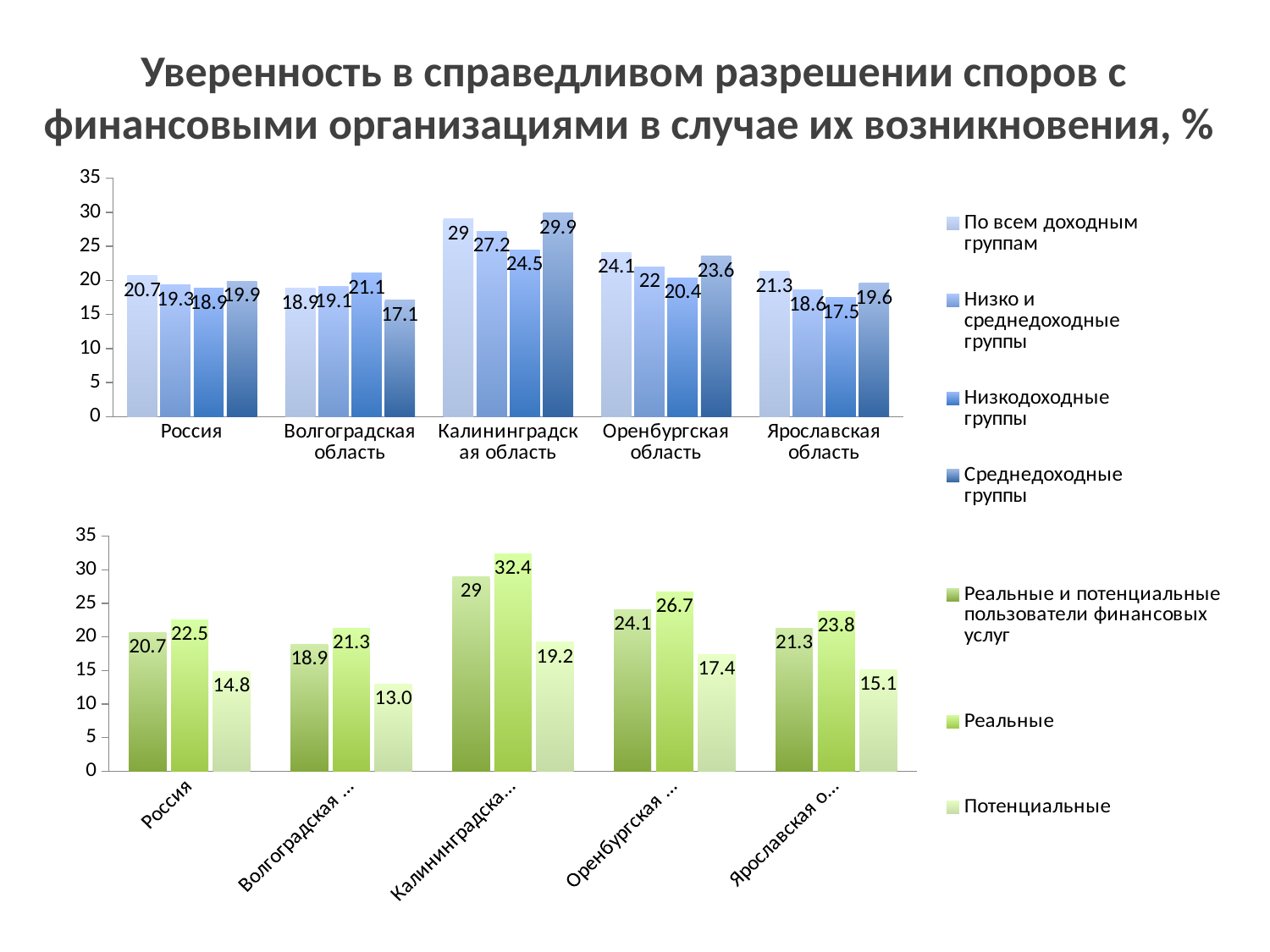
In the top chart, which region has the highest value in the series 'По всем доходным группам'? Калининградская область In the bottom chart, which series has the lowest value for Россия? Потенциальные In the bottom chart, what is the value for Россия in the series 'Потенциальные'? 14.8 In the top chart, what is the difference between the 'По всем доходным группам' values for Оренбургская область and Ярославская область? 2.8 In the top chart, what is the value for Волгоградская область in the series 'Низкодоходные группы'? 21.1 In the bottom chart, what is the value for Россия in the series 'Реальные'? 22.5 What type of chart is the bottom chart? Bar chart In the top chart, what is the value for Россия in the series 'По всем доходным группам'? 20.7 In the top chart, which region has the lowest value in the series 'Среднедоходные группы'? Волгоградская область In the top chart, what is the value for Калининградская область in the series 'Среднедоходные группы'? 29.9 How many series does the legend of the top chart list? 4 In the bottom chart, is the value for Россия in the series 'Реальные' greater or less than 20? greater